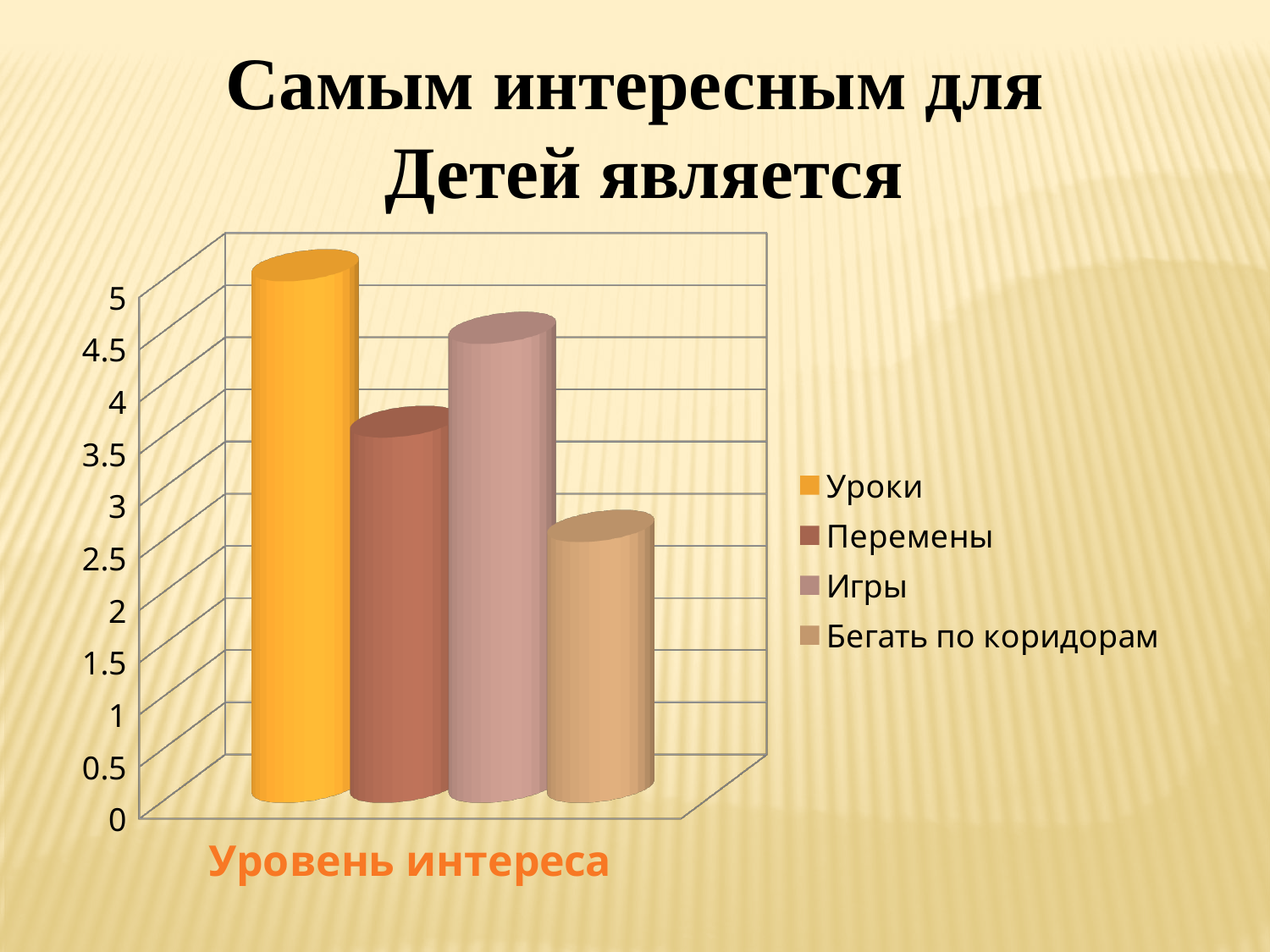
Is the value for Уроки greater or less than 4? greater Is the value for Перемены greater or less than 4? less Which is larger, the value for Игры or the value for Перемены? Игры Is the value for Игры greater or less than 4? greater Which series has the lowest bar? Бегать по коридорам What is the highest value shown on the vertical axis? 5 How many series does the legend list? 4 What is the category label shown below the bars on the x axis? Уровень интереса What kind of chart is shown on the slide? bar chart Which series has the highest bar? Уроки Which is larger, the value for Уроки or the value for Бегать по коридорам? Уроки